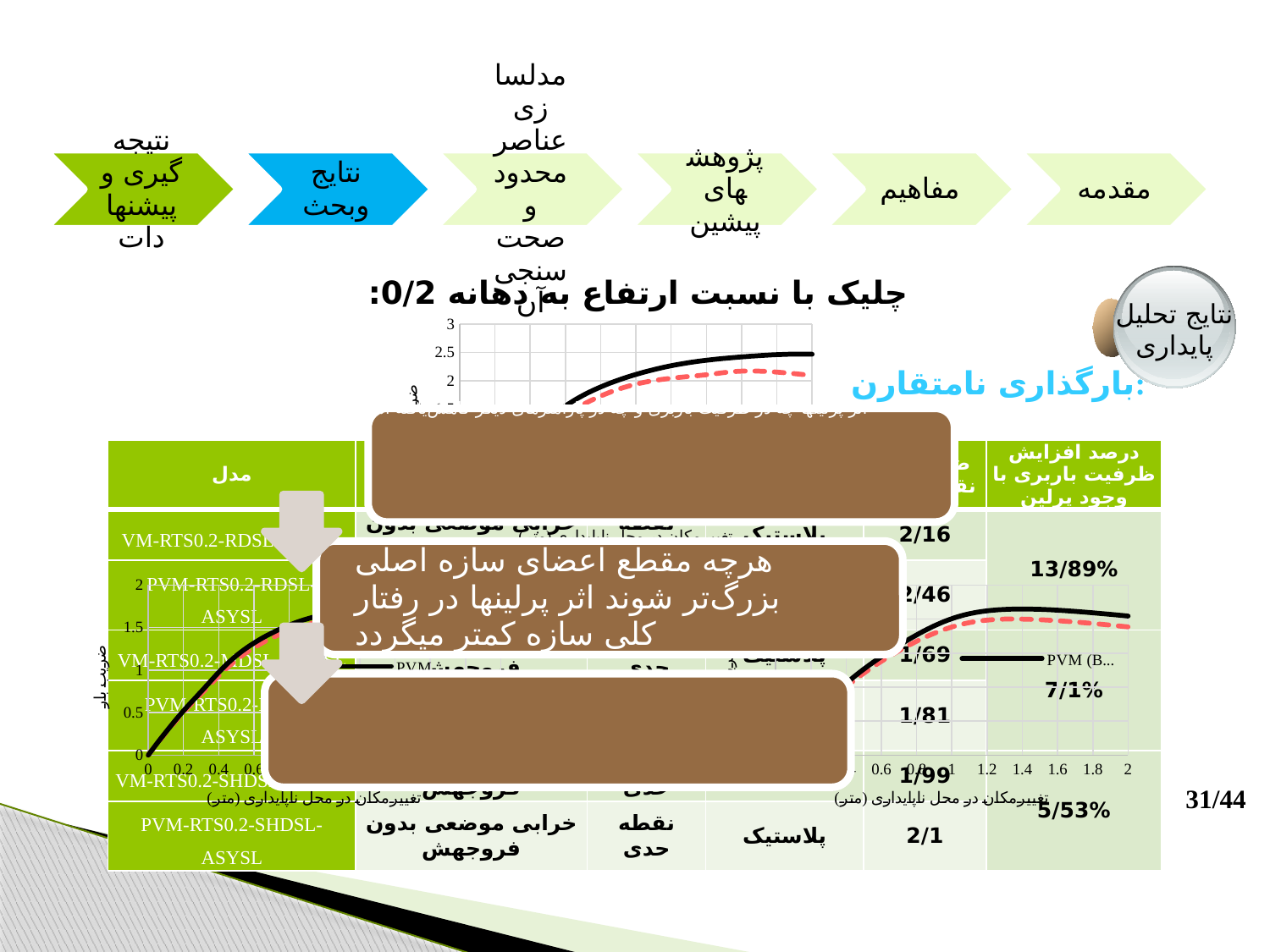
What kind of chart is the chart at the top centre of the slide? line chart In the top centre chart, do the plotted values rise or fall as the x-axis value increases? rise In the top centre chart, which line is higher at the right end of the x axis, the solid black line or the dashed red line? the solid black line In the top centre chart, is the value of the dashed red line at the right end of the x axis greater or less than 2? greater In the bottom left chart, do the plotted values rise or fall as the x-axis value increases from 0? rise What is the highest tick value shown on the y axis of the top centre chart? 3 How many data series (lines) are plotted in the top centre chart? 2 What is the x-axis label of the bottom right chart? تغییرمکان در محل ناپایداری (متر) In the top centre chart, is the value of the solid black line at the right end of the x axis greater or less than 2? greater What kind of chart is the chart at the bottom right of the slide? line chart